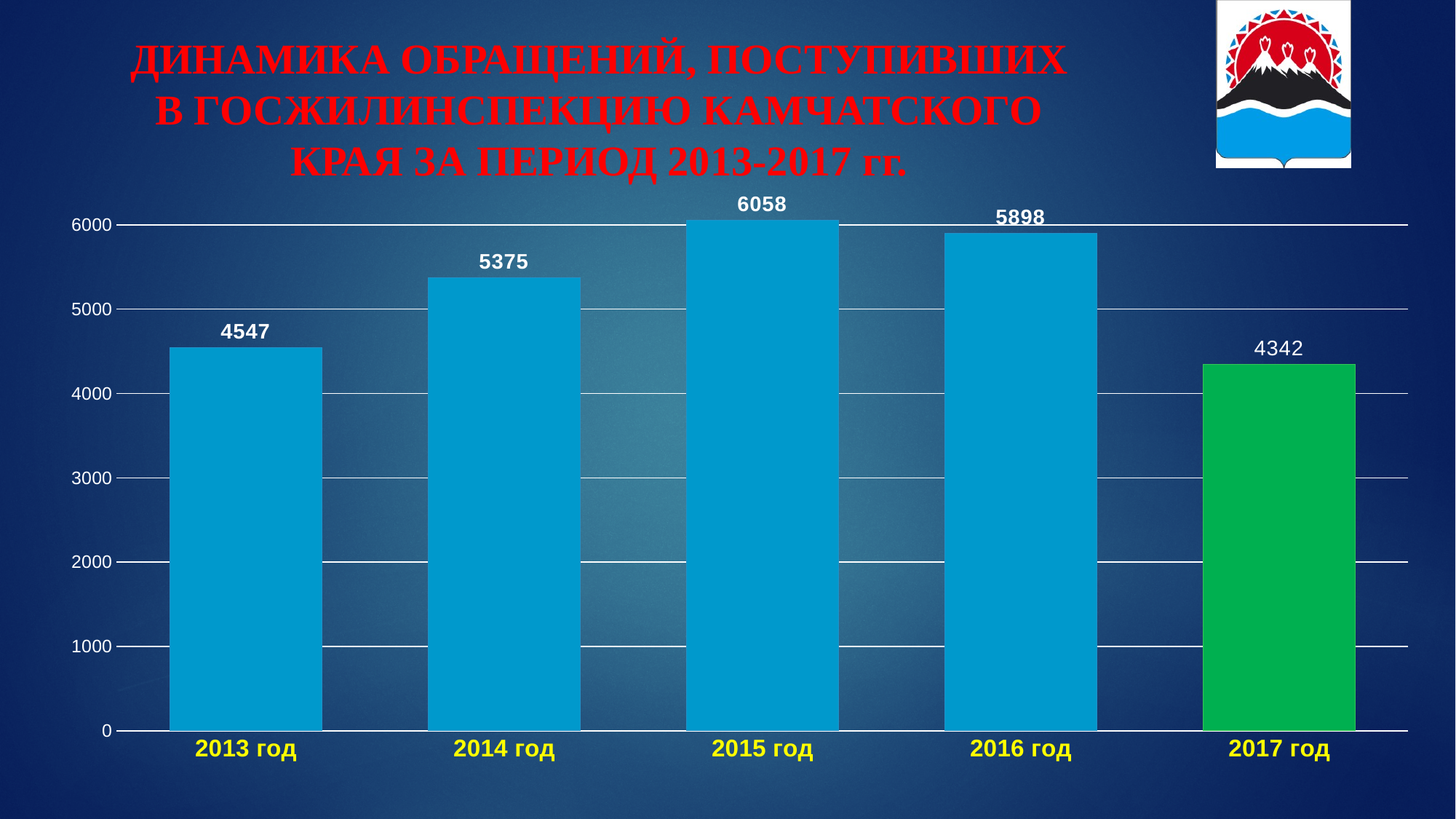
Is the value for 2016 год greater or less than 5000? greater Which year has the highest value? 2015 год What is the difference between the values for 2015 год and 2016 год? 160 How many years are shown on the chart? 5 What kind of chart is shown on the slide? bar chart What is the difference between the values for 2014 год and 2013 год? 828 What is the value for 2015 год? 6058 Which year has the lowest value? 2017 год Which is larger, the value for 2013 год or the value for 2017 год? 2013 год What is the value for 2013 год? 4547 What is the value for 2017 год? 4342 Which bar is coloured green rather than blue? 2017 год